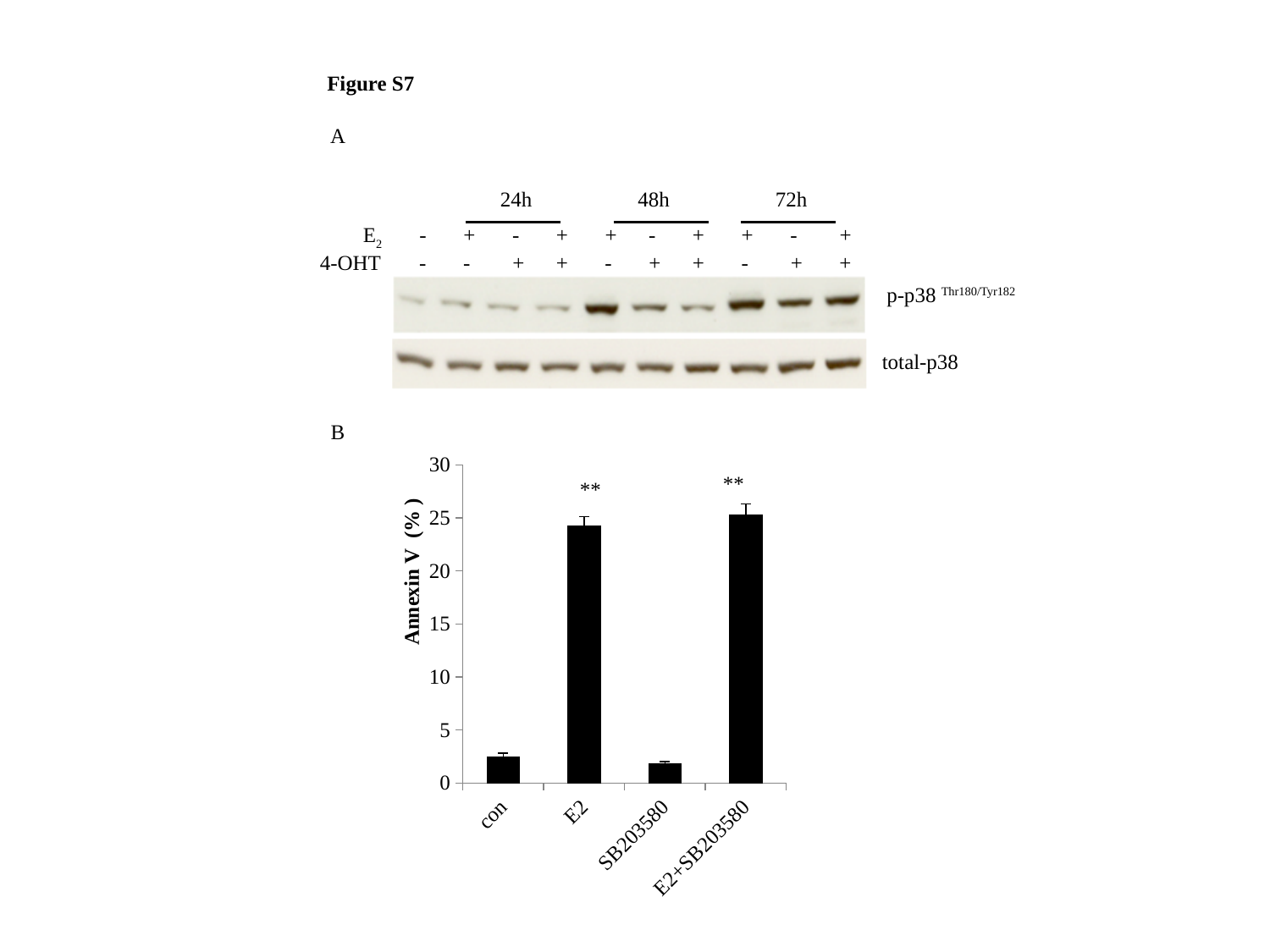
In the panel B chart, how many categories are shown on the x axis? 4 In the panel B chart, which is larger, the value for con or the value for E2? E2 In the panel B chart, is the value for SB203580 greater or less than 5? less In the panel B chart, which categories are marked with ** above their bars? E2 and E2+SB203580 In the panel B chart, is the value for E2 greater or less than 20? greater In the panel B chart, is the value for E2 greater or less than 30? less What kind of chart is shown in panel B of the slide? bar chart What is the y-axis label of the panel B chart? Annexin V (%) In the panel B chart, which is larger, the value for E2 or the value for SB203580? E2 In the panel B chart, which is larger, the value for SB203580 or the value for E2+SB203580? E2+SB203580